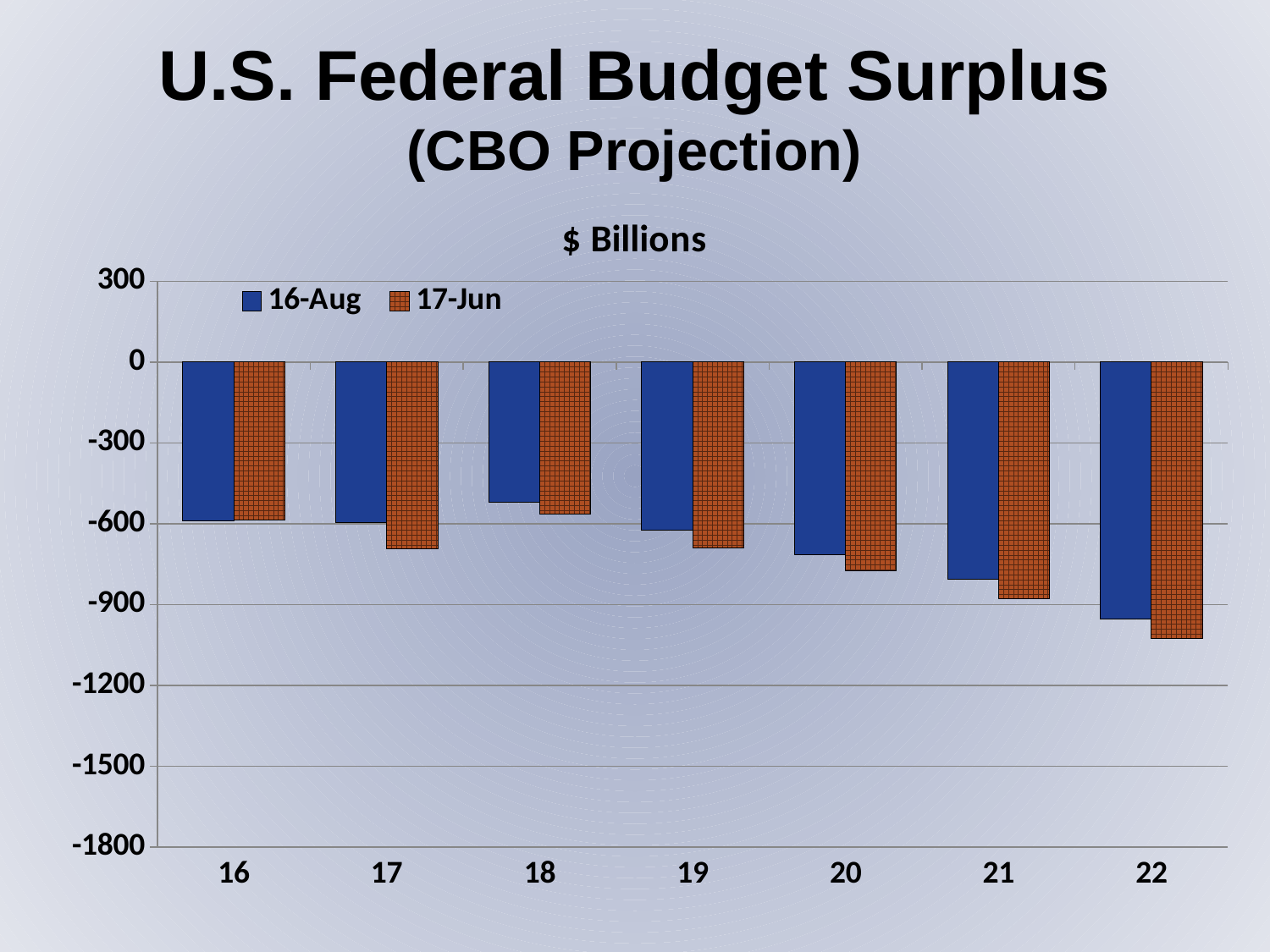
Is the 17-Jun value for year 22 greater or less than -900? less What kind of chart is shown on the slide? bar chart In year 22, which series has the lower (more negative) value, 16-Aug or 17-Jun? 17-Jun From year 18 to year 22, do the 17-Jun values rise or fall? fall Which year has the lowest (most negative) value for the 16-Aug series? 22 What unit label appears above the chart? $ Billions Which year has the lowest (most negative) value for the 17-Jun series? 22 How many years are shown on the x axis? 7 How many series does the legend list? 2 Is the 16-Aug value for year 18 greater or less than -600? greater What are the two series named in the legend? 16-Aug and 17-Jun Which year has the highest (least negative) value for the 16-Aug series? 18